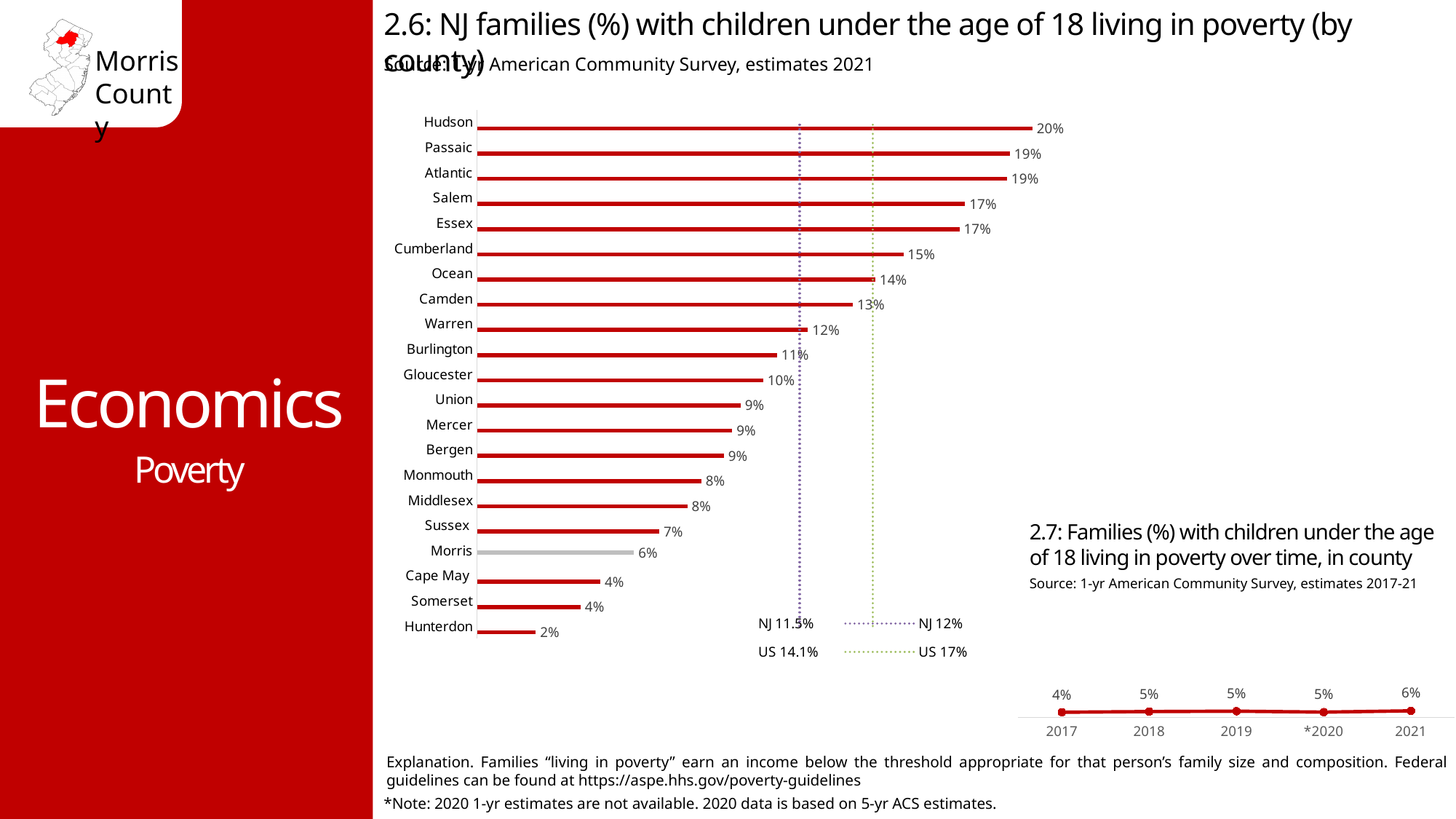
In chart 2.6, which county has the lowest percentage of families with children under 18 living in poverty? Hunterdon What kind of chart is chart 2.6? Bar chart In chart 2.6, what is the value shown for Essex? 17% In chart 2.6, what is the difference in percentage points between Hudson and Morris? 14 In chart 2.7, what is the value for 2021? 6% In chart 2.6, which county has the highest percentage of families with children under 18 living in poverty? Hudson In chart 2.6, what percentage of families with children under 18 live in poverty in Morris County? 6% In chart 2.7, do the values rise or fall from 2017 to 2021? Rise How many years are plotted in chart 2.7? 5 In chart 2.6, which county has a higher value, Cumberland or Camden? Cumberland How many counties are plotted in chart 2.6? 21